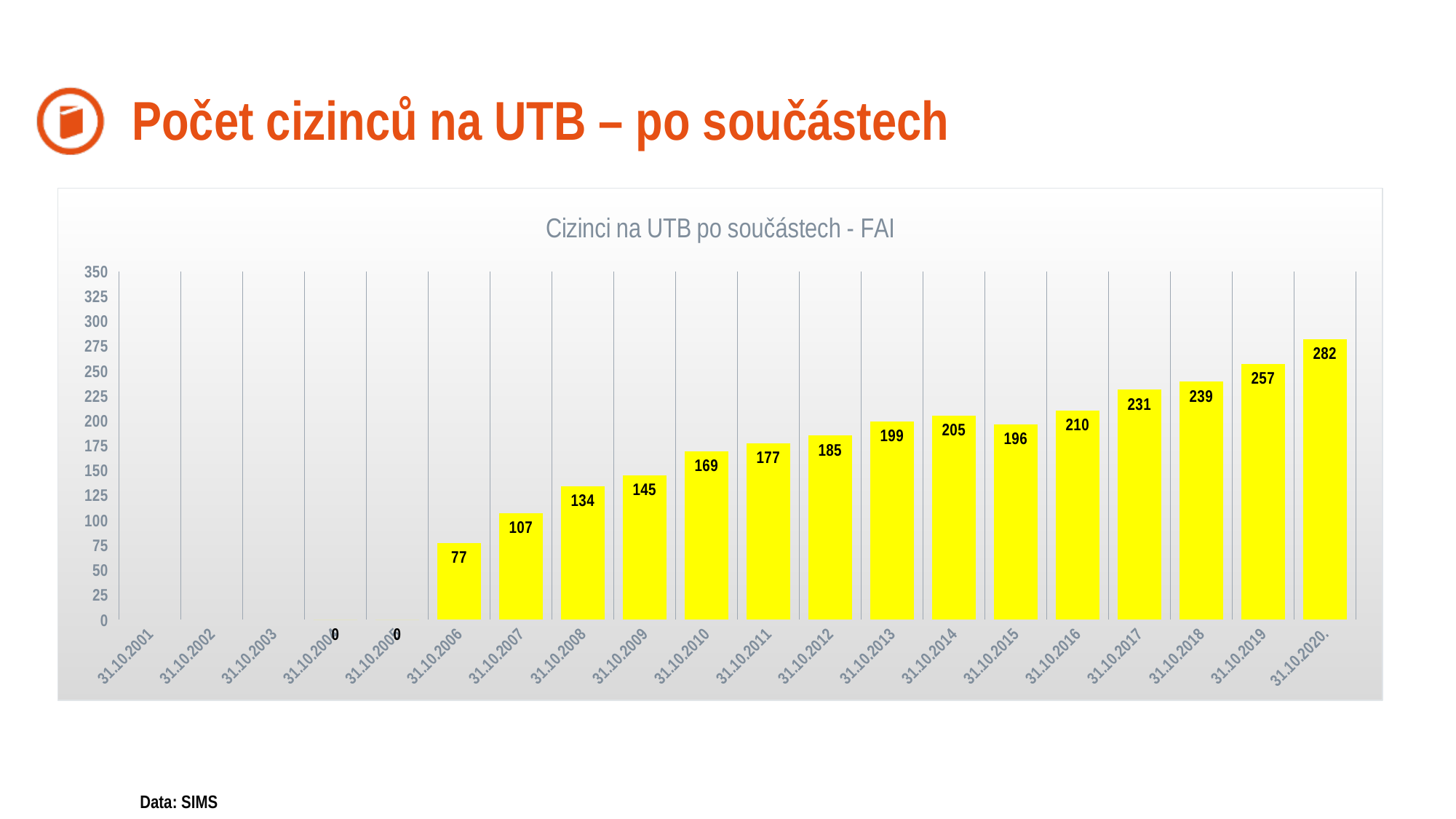
What is the title of the chart? Cizinci na UTB po součástech - FAI What is the value for 31.10.2020 in the chart? 282 How many dates are shown on the x axis of the chart? 20 Do the values generally rise or fall from 31.10.2006 to 31.10.2020? rise What is the value for 31.10.2006? 77 What is the value for 31.10.2015? 196 What is the difference between the values for 31.10.2020 and 31.10.2019? 25 Which date has the lowest non-zero value in the chart? 31.10.2006 Which date has the highest value in the chart? 31.10.2020 What kind of chart is shown on the slide? bar chart What is the difference between the values for 31.10.2014 and 31.10.2015? 9 Which is larger, the value for 31.10.2014 or the value for 31.10.2015? 31.10.2014